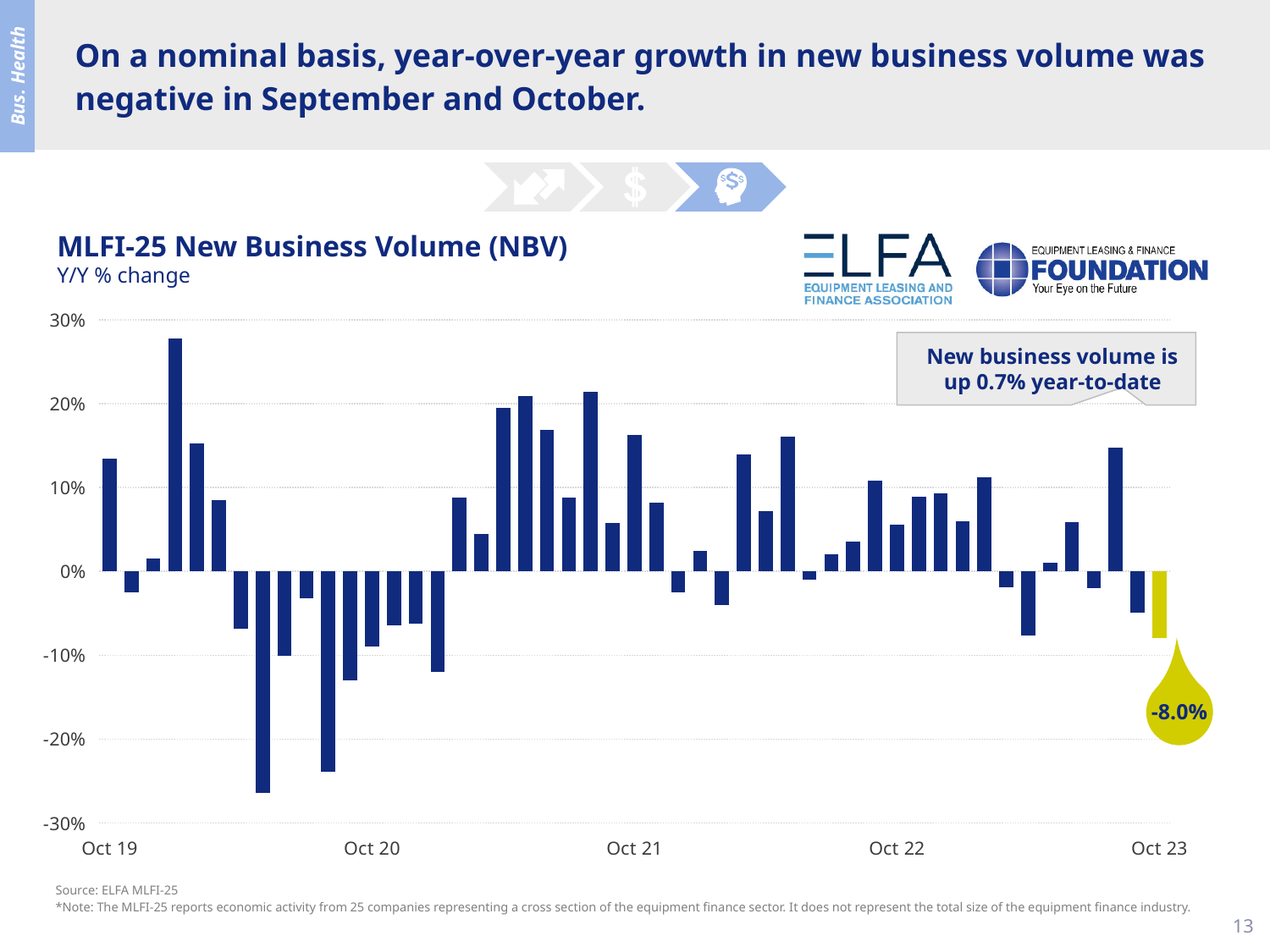
How many labels are shown on the x axis of the chart? 5 What is the Y/Y % change in new business volume shown for Oct 23? -8.0% Which has the larger Y/Y % change, Oct 19 or Oct 23? Oct 19 Is the value for Oct 21 greater or less than 10%? greater What is the title of the chart? MLFI-25 New Business Volume (NBV) According to the callout on the chart, by how much is new business volume up year-to-date? 0.7% Is the tallest bar on the chart greater or less than 20%? greater Is the value for Oct 23 greater or less than 0%? less What kind of chart is used to show MLFI-25 New Business Volume? Bar chart Which has the larger Y/Y % change, Oct 20 or Oct 21? Oct 21